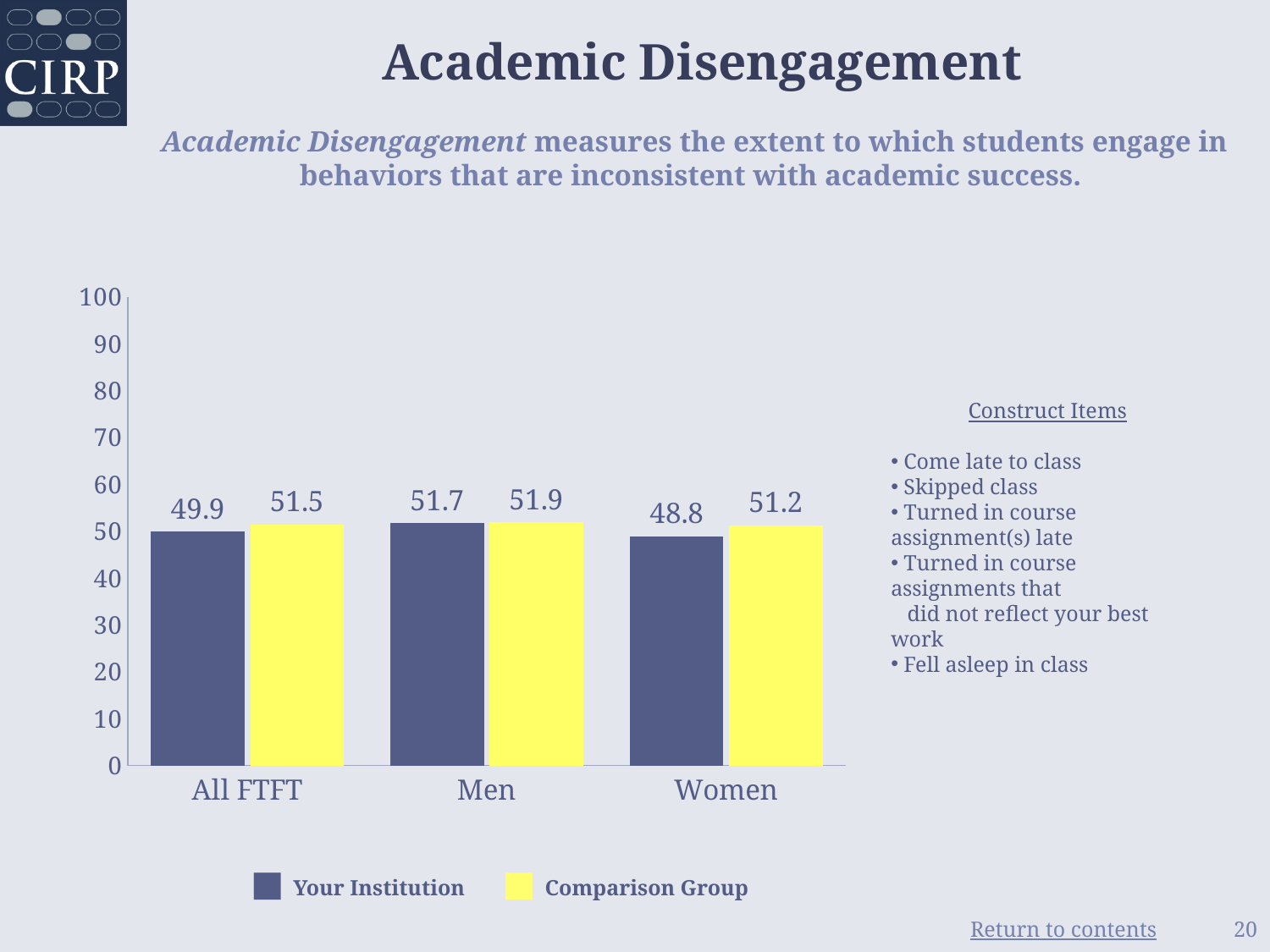
What is the difference between the Comparison Group and Your Institution values for All FTFT? 1.6 Which category has the lowest Your Institution value? Women What is the Your Institution value for All FTFT? 49.9 Which category has the highest Your Institution value? Men For Women, which is larger: Your Institution or Comparison Group? Comparison Group What is the Comparison Group value for Men? 51.9 What is the Comparison Group value for Women? 51.2 What is the Your Institution value for Women? 48.8 What is the difference between the Comparison Group and Your Institution values for Women? 2.4 How many series does the legend list? 2 How many categories are shown on the x axis? 3 What kind of chart is shown on the slide? Bar chart